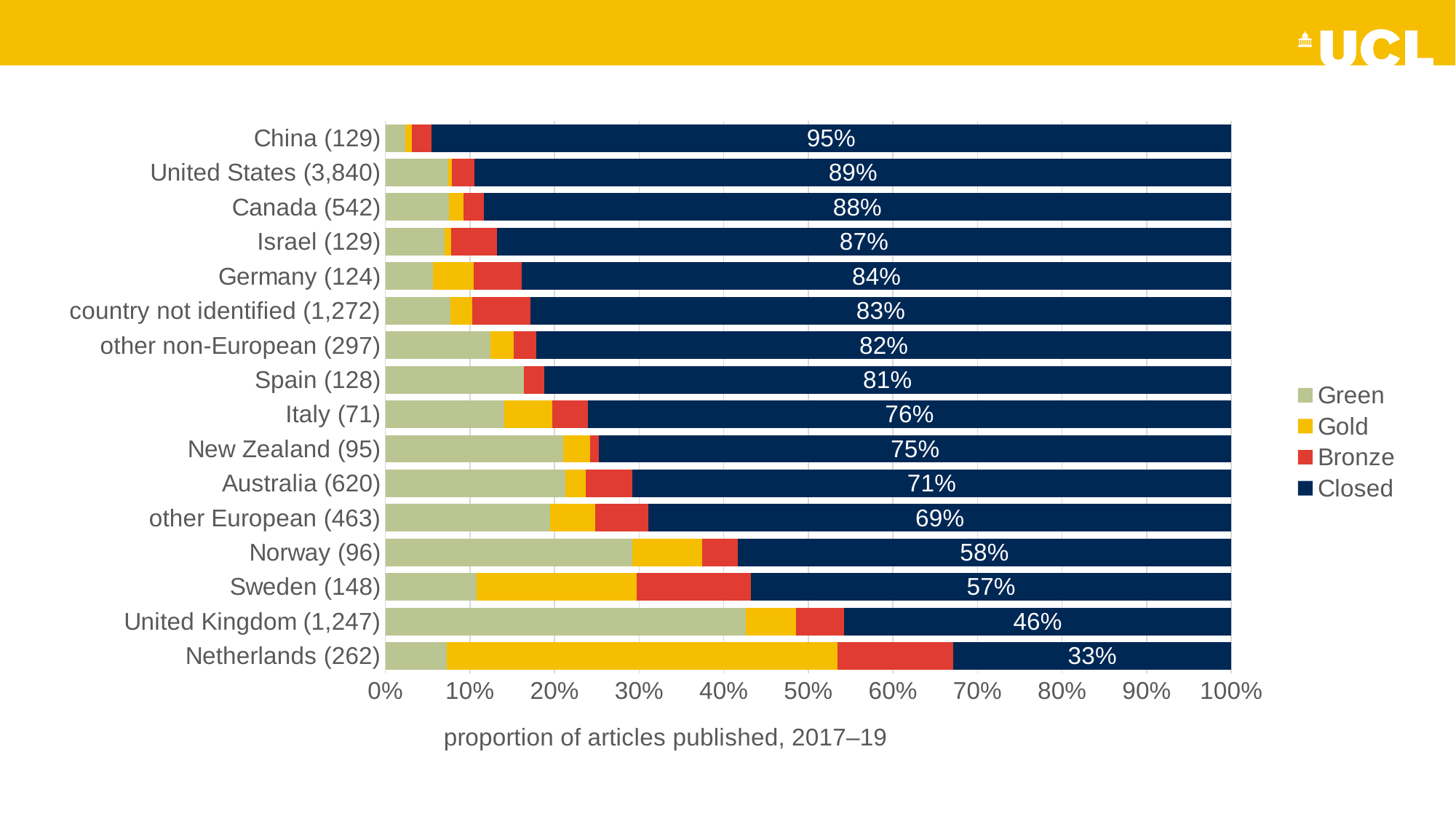
Is the Green share for United Kingdom (1,247) greater or less than 40%? greater Which category has the lowest Closed share? Netherlands (262) Which category has the highest Closed share? China (129) How many series does the legend list? 4 Which has a larger Closed share, Italy (71) or Australia (620)? Italy (71) How many categories are shown on the chart? 16 What is the Closed share for China (129)? 95% What is the x-axis title of the chart? proportion of articles published, 2017–19 Is the Green share for Netherlands (262) greater or less than 10%? less What is the difference between the Closed share for China (129) and Netherlands (262)? 62 percentage points What is the Closed share for Netherlands (262)? 33% What is the Closed share for United Kingdom (1,247)? 46%